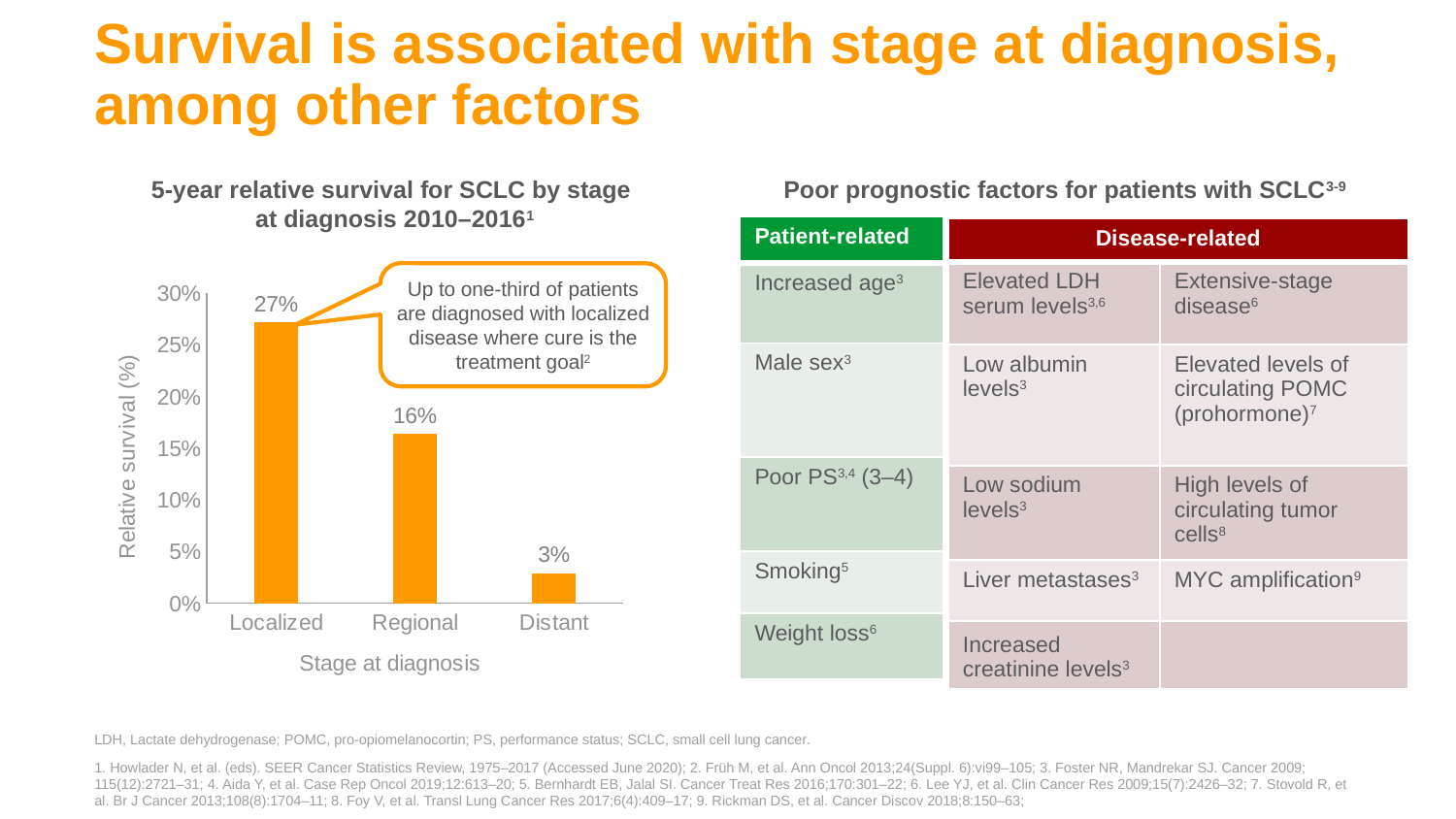
What is the difference in 5-year relative survival between the Regional and Distant stages? 13% Is the value for Localized greater or less than 25%? greater What is the difference in 5-year relative survival between the Localized and Regional stages? 11% What is the 5-year relative survival for the Regional stage? 16% What is the 5-year relative survival for the Localized stage? 27% What is the 5-year relative survival for the Distant stage? 3% What is the label of the y axis of the chart? Relative survival (%) How many stage categories are shown in the chart? 3 What kind of chart is used to show 5-year relative survival by stage? Bar chart Which has a higher 5-year relative survival, Regional or Distant? Regional Which stage at diagnosis has the highest 5-year relative survival? Localized Which stage at diagnosis has the lowest 5-year relative survival? Distant